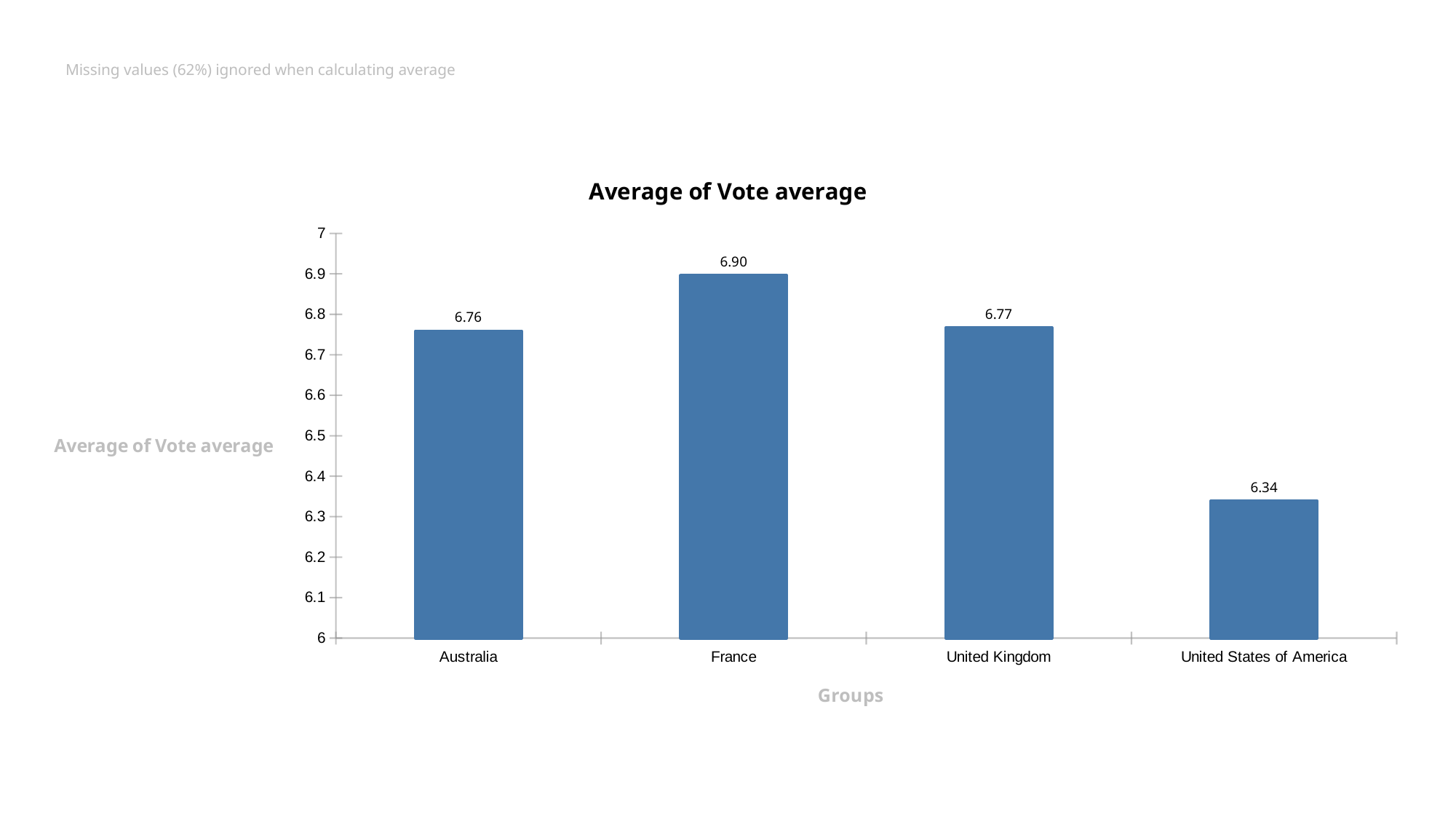
How many groups are shown on the x axis? 4 What kind of chart is shown on the slide? bar chart Which is larger, the value for France or the value for United Kingdom? France What is the difference between the values for United Kingdom and Australia? 0.01 What is the average of Vote average for France? 6.90 What is the average of Vote average for United States of America? 6.34 What is the difference between the values for France and United States of America? 0.56 What is the title of the chart? Average of Vote average Which group has the highest average of Vote average? France Which group has the lowest average of Vote average? United States of America Is the value for United States of America greater or less than 6.5? less What is the average of Vote average for Australia? 6.76